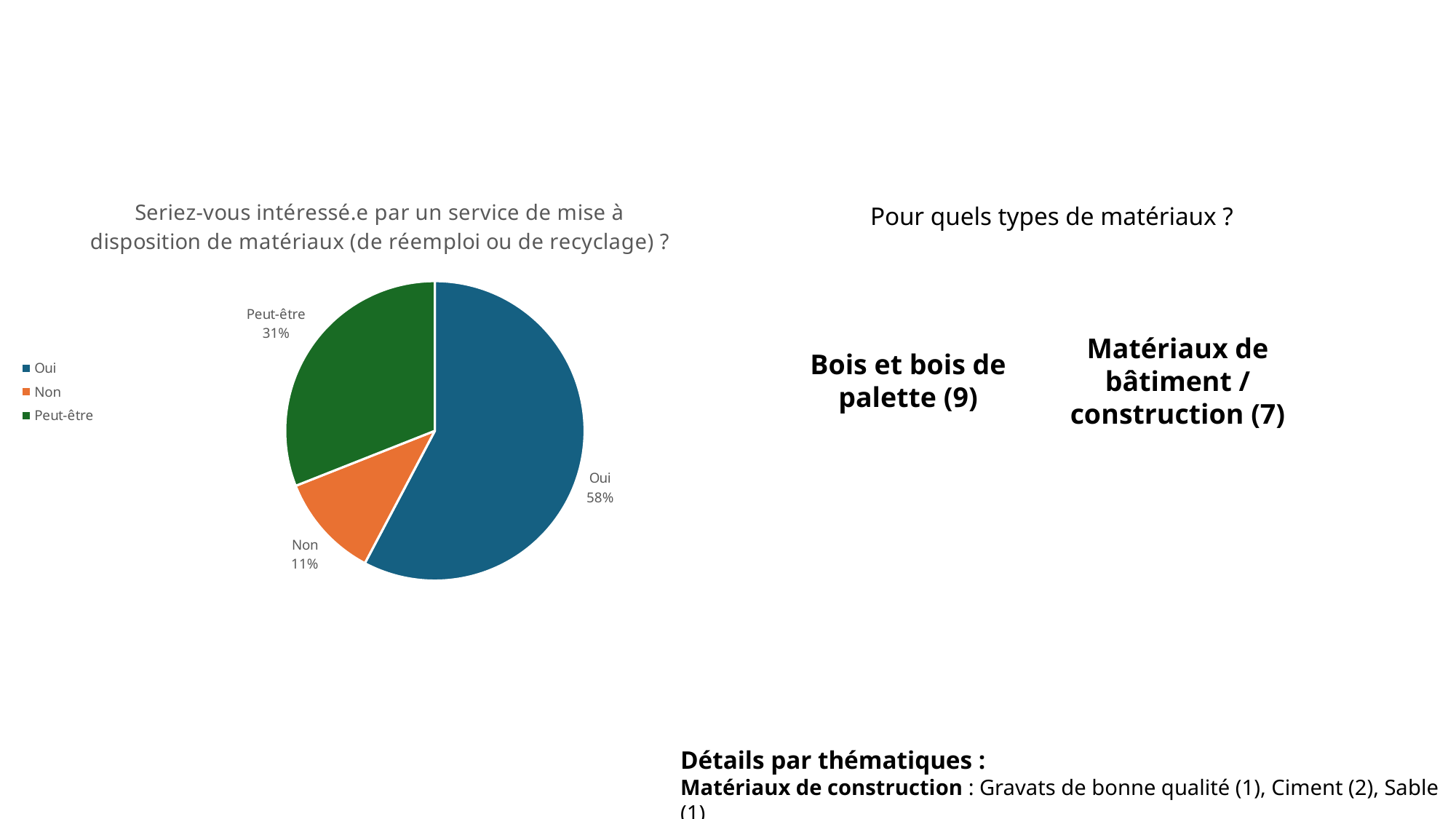
What is the difference in percentage points between "Oui" and "Peut-être"? 27 What colour is the "Non" slice in the pie chart? orange What share of the pie does "Oui" represent? 58% What share of the pie does "Peut-être" represent? 31% Which category has the largest slice of the pie? Oui How many entries does the legend list? 3 What is the title of the pie chart? Seriez-vous intéressé.e par un service de mise à disposition de matériaux (de réemploi ou de recyclage) ? How many categories are shown in the pie chart? 3 Which category has the smallest slice of the pie? Non Which is larger, the share for "Peut-être" or the share for "Non"? Peut-être What type of chart is shown on the slide? pie chart What share of the pie does "Non" represent? 11%